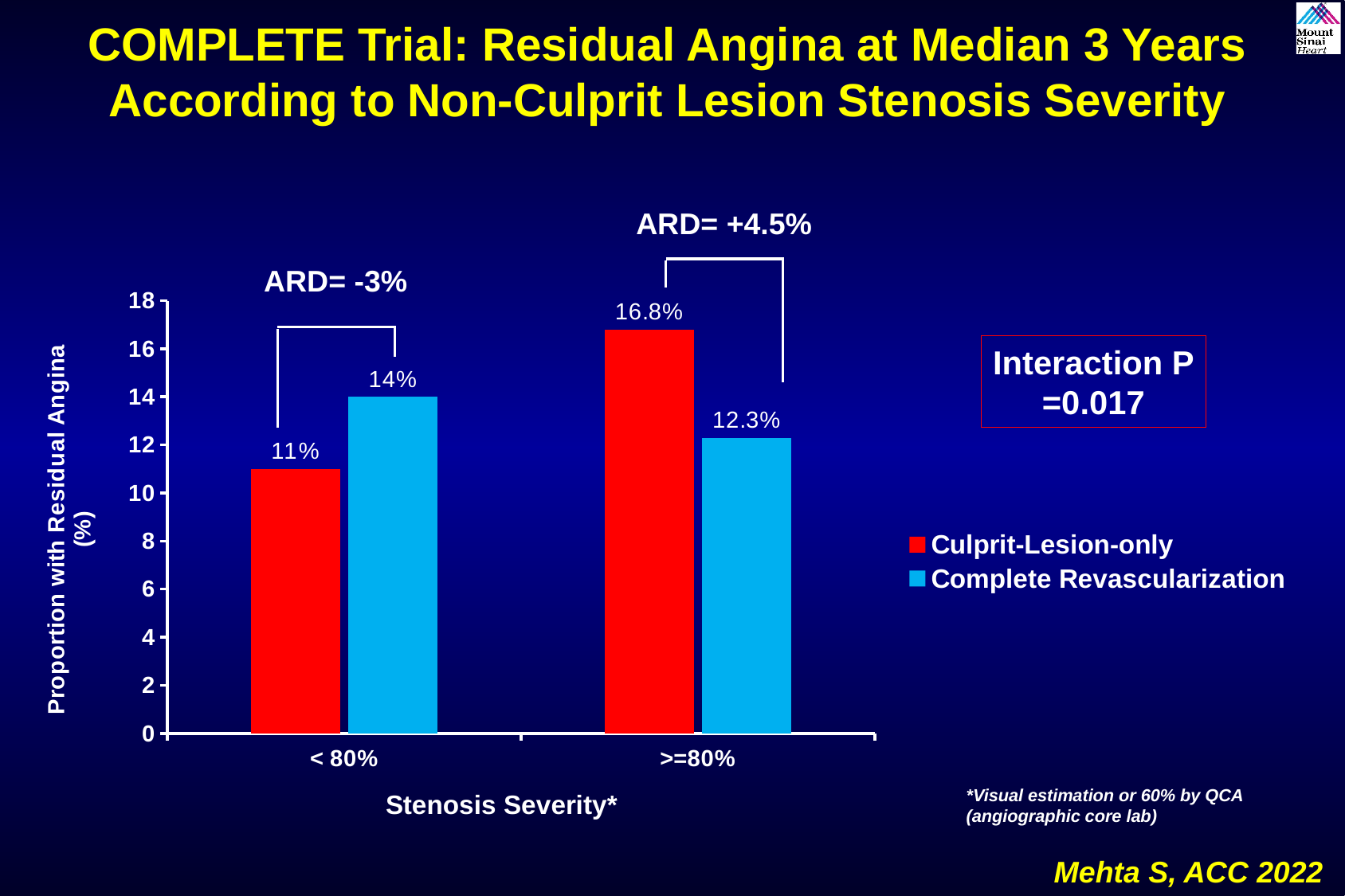
What is the proportion with residual angina for Complete Revascularization in the >=80% stenosis severity group? 12.3% Is the Culprit-Lesion-only value in the >=80% group greater or less than 16? greater How many stenosis severity categories are shown on the x axis? 2 What is the proportion with residual angina for Culprit-Lesion-only in the < 80% stenosis severity group? 11% In the < 80% group, which series has the larger proportion with residual angina? Complete Revascularization Which bar has the highest proportion with residual angina? Culprit-Lesion-only, >=80% What is the interaction P value shown on the slide? 0.017 What kind of chart is shown on the slide? Bar chart Which bar has the lowest proportion with residual angina? Culprit-Lesion-only, < 80% What is the proportion with residual angina for Complete Revascularization in the < 80% group? 14% What is the difference between the Culprit-Lesion-only and Complete Revascularization values in the >=80% group? 4.5% How many series does the legend list? 2